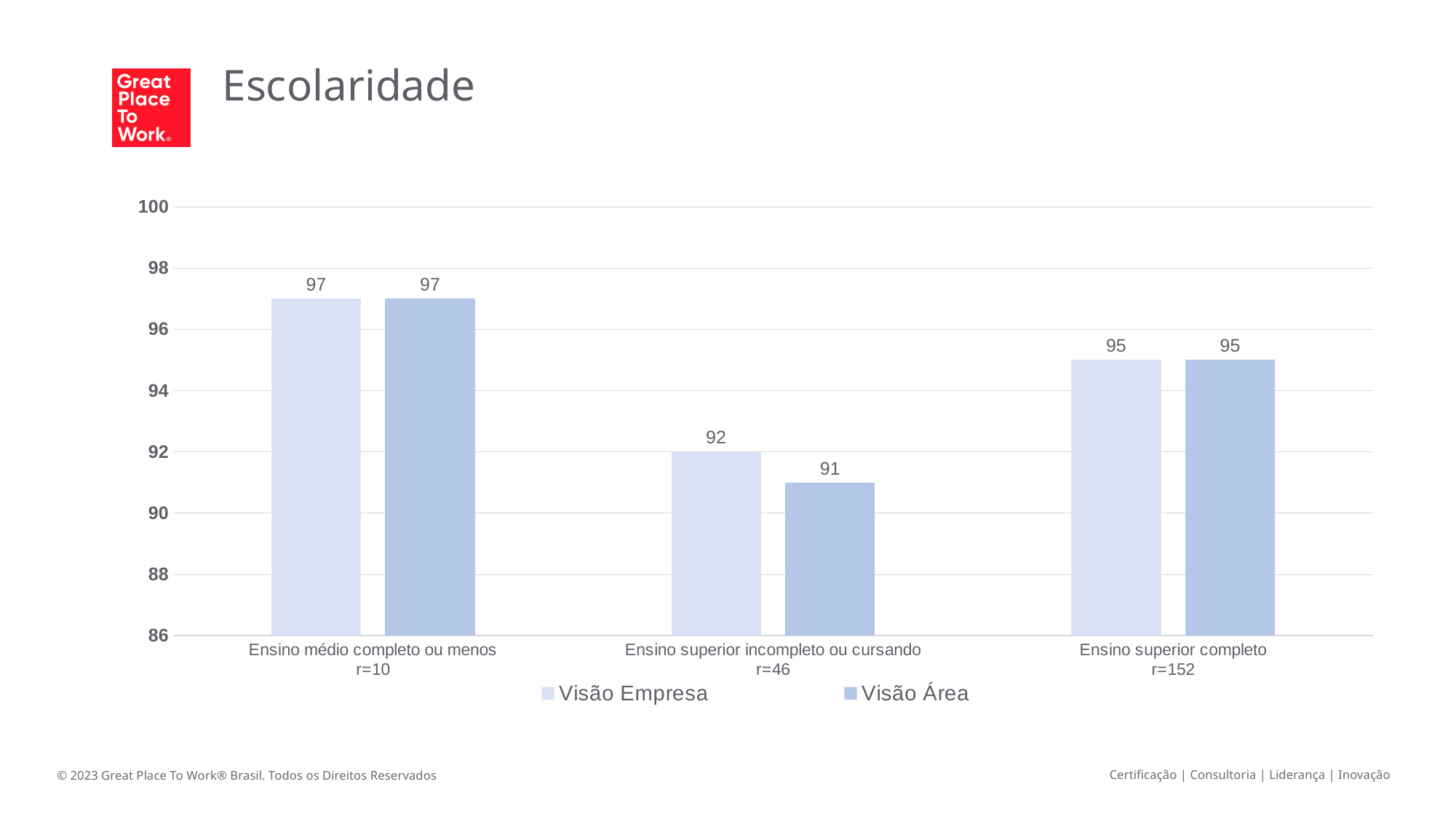
What kind of chart is shown on the slide? Bar chart Which category has the lowest Visão Área value? Ensino superior incompleto ou cursando What is the title of the slide? Escolaridade What is the Visão Área value for Ensino superior completo? 95 Which category has the highest Visão Empresa value? Ensino médio completo ou menos What is the Visão Área value for Ensino superior incompleto ou cursando? 91 How many series does the legend list? 2 What is the difference between the Visão Empresa values for Ensino médio completo ou menos and Ensino superior completo? 2 What is the difference between the Visão Empresa and Visão Área values for Ensino superior incompleto ou cursando? 1 Which is larger: the Visão Empresa value for Ensino superior incompleto ou cursando or the Visão Empresa value for Ensino superior completo? Ensino superior completo How many categories are shown on the x axis? 3 What is the Visão Empresa value for Ensino médio completo ou menos? 97